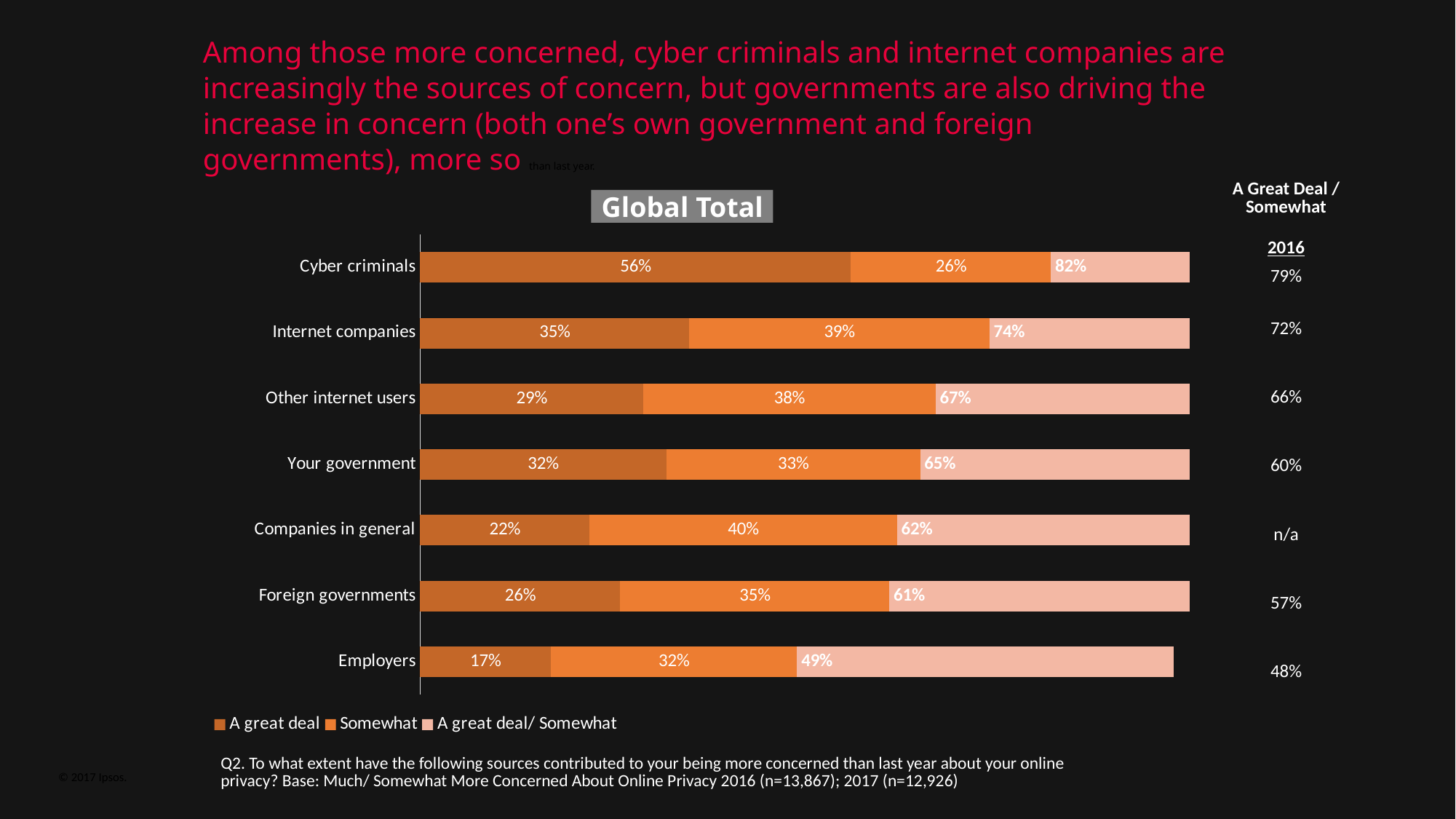
What is the combined 'A great deal/ Somewhat' value for Employers? 49% What is the 'Somewhat' value for Internet companies? 39% How many series does the legend list? 3 What type of chart is shown on the slide? Stacked bar chart What is the title shown above the chart? Global Total What is the difference between the 'A great deal' values for Cyber criminals and Internet companies? 21 percentage points Which category has the highest 'A great deal' value? Cyber criminals Which has a larger 'Somewhat' value: Companies in general or Your government? Companies in general Which category has the lowest combined 'A great deal/ Somewhat' value? Employers What percentage of respondents said cyber criminals contributed 'A great deal' to their increased concern? 56% How many categories are shown in the chart? 7 What is the 'A great deal' value for Foreign governments? 26%